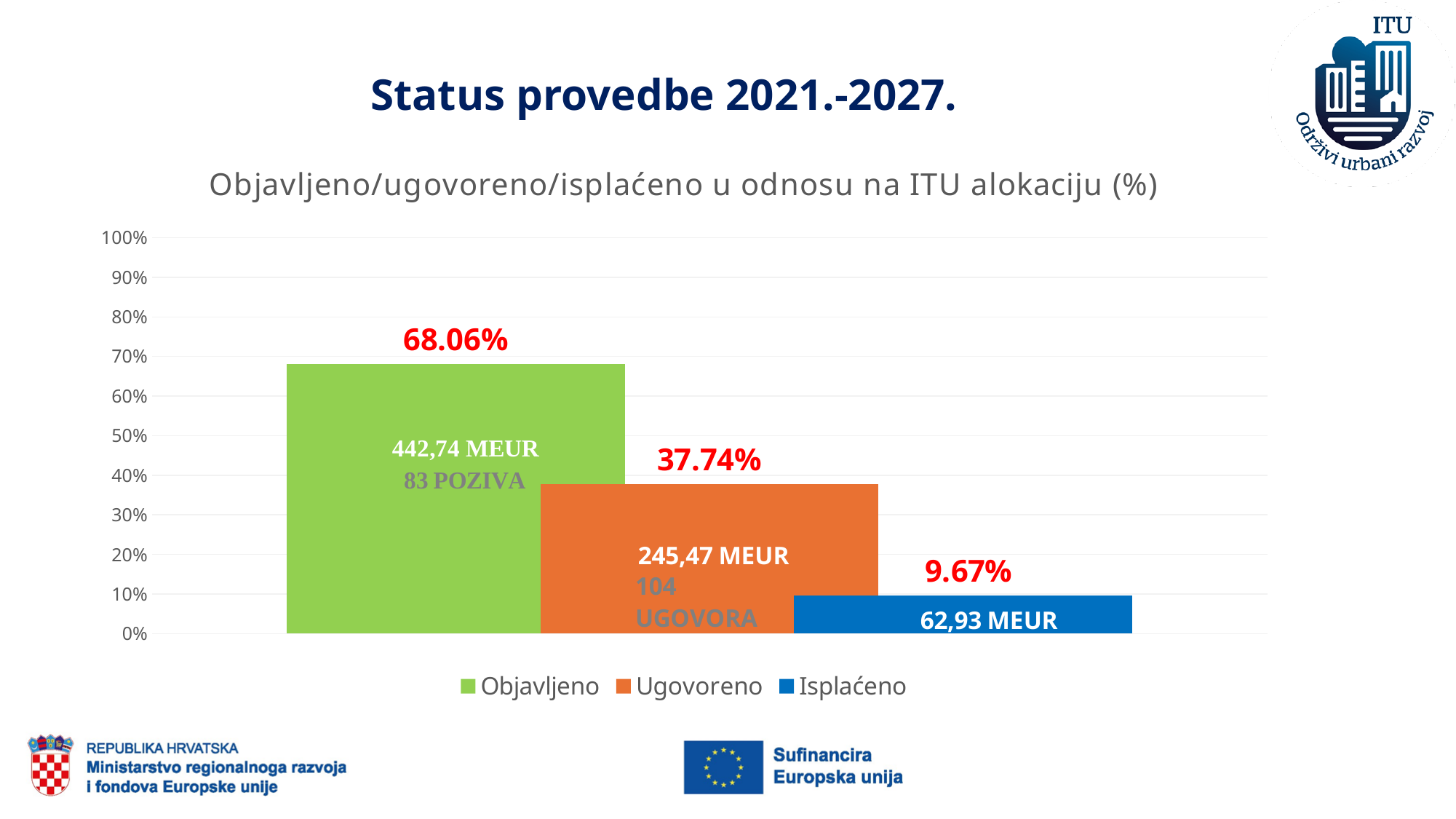
What percentage is shown for Objavljeno? 68.06% What is the difference in percentage points between Ugovoreno and Isplaćeno? 28.07 Which is larger, the value for Ugovoreno or the value for Isplaćeno? Ugovoreno What amount in MEUR is printed on the Objavljeno bar? 442,74 MEUR Which series has the lowest percentage? Isplaćeno What is the difference in percentage points between Objavljeno and Ugovoreno? 30.32 What percentage is shown for Ugovoreno? 37.74% What amount in MEUR is printed on the Isplaćeno bar? 62,93 MEUR What type of chart is shown on the slide? Bar chart Which series has the highest percentage? Objavljeno What percentage is shown for Isplaćeno? 9.67% How many series does the legend list? 3